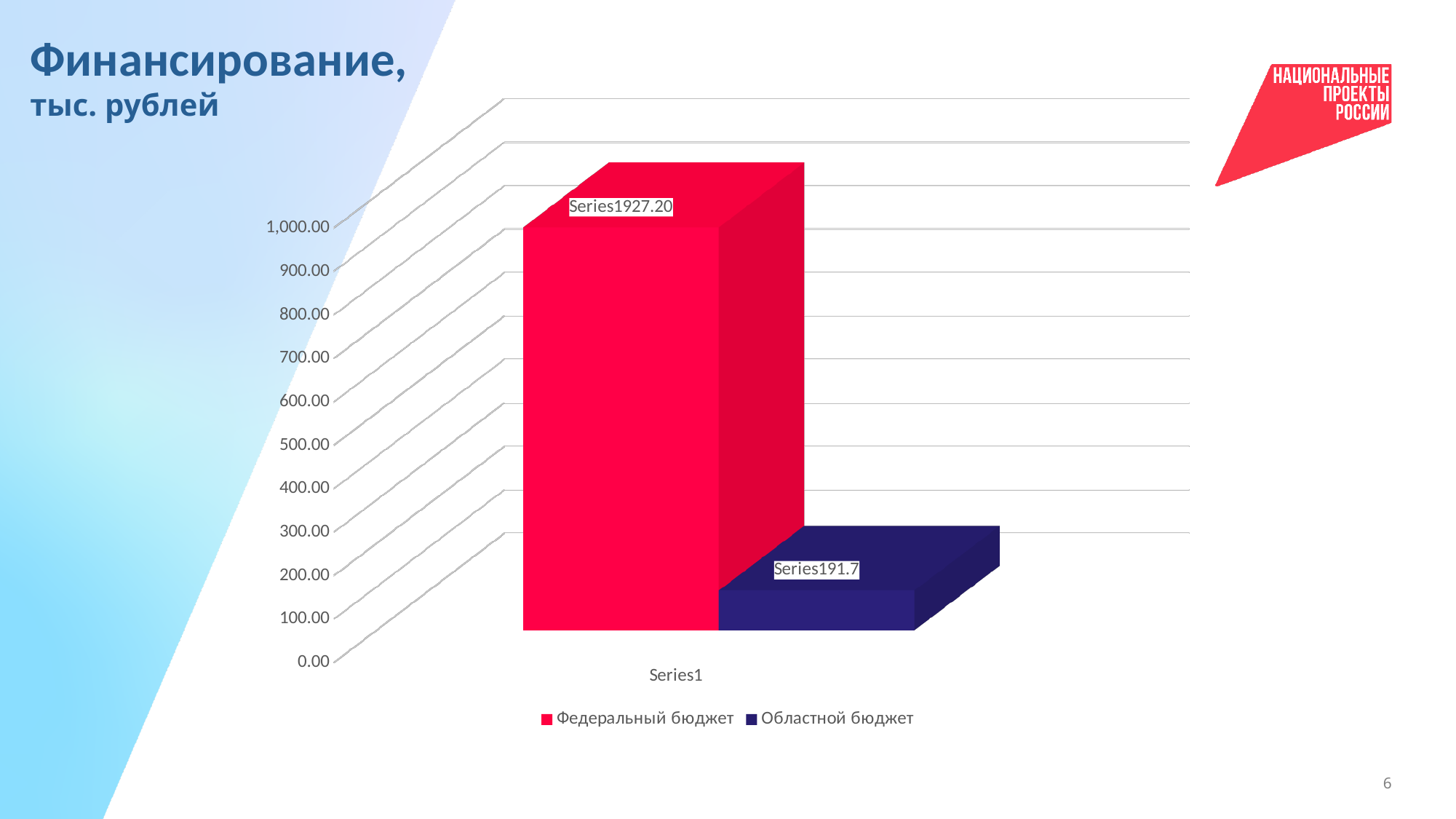
How many series does the legend list? 2 What kind of chart is shown on the slide? bar chart Is the value for Федеральный бюджет greater or less than 900.00? greater What is the title of the chart on the slide? Финансирование, тыс. рублей What is the value shown on the data label for Федеральный бюджет? 927.20 Which series has the highest value, Федеральный бюджет or Областной бюджет? Федеральный бюджет What is the difference between the Федеральный бюджет value (927.20) and the Областной бюджет value (91.7)? 835.5 Which series has the lowest value? Областной бюджет Is the value for Областной бюджет greater or less than 100.00? less Which is larger, the value for Федеральный бюджет or the value for Областной бюджет? Федеральный бюджет What colour represents Областной бюджет in the legend? dark blue What is the value shown on the data label for Областной бюджет? 91.7